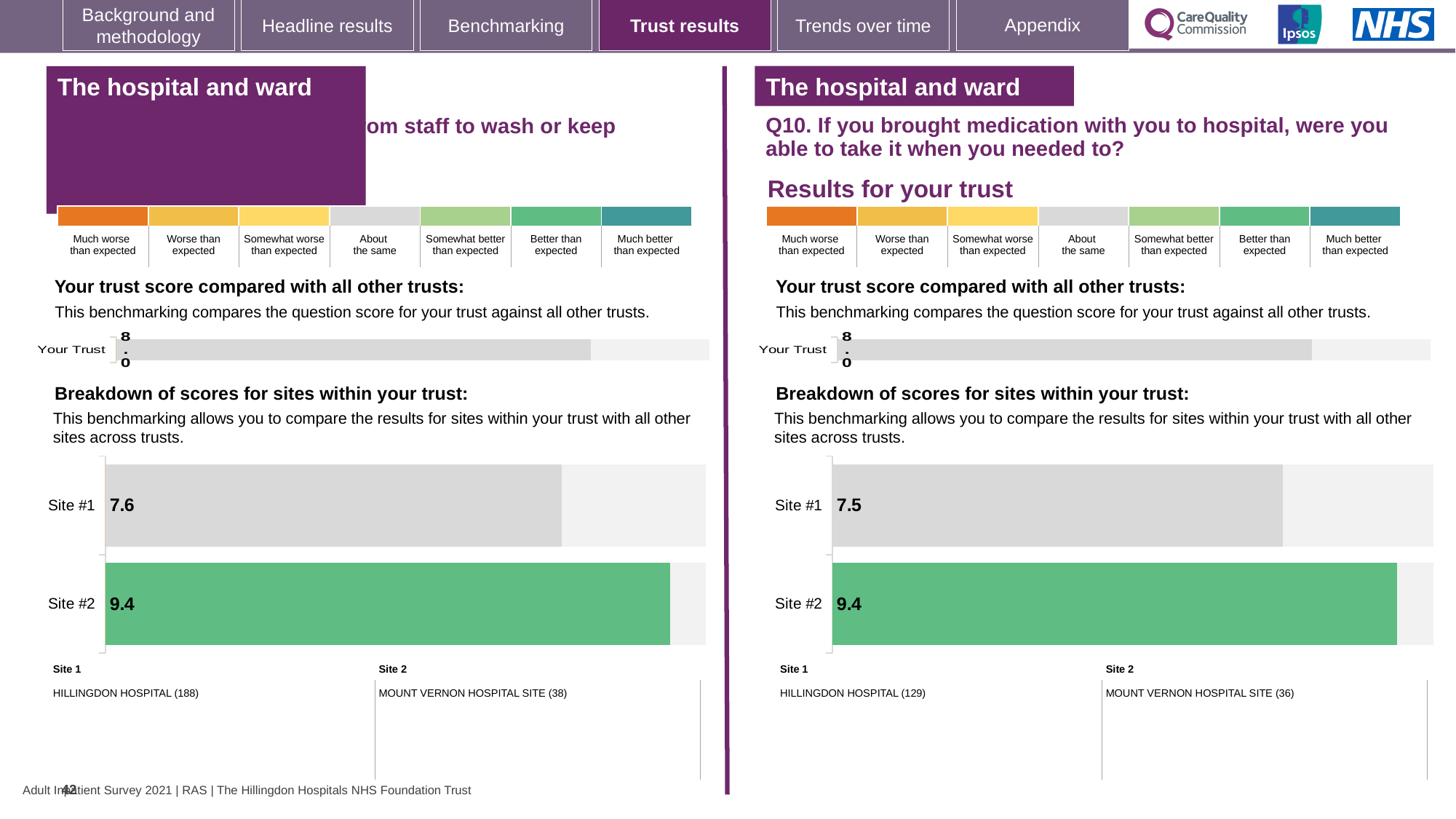
In the site breakdown chart on the right-hand side of the slide (Q10), which site has the higher score? Site #2 What type of chart is used for the site breakdown on the right-hand side of the slide (Q10)? Bar chart In the site breakdown chart on the right-hand side of the slide (Q10), what is the score for Site #1? 7.5 In the site breakdown chart on the left-hand side of the slide, what is the score for Site #1? 7.6 How many sites are shown in the site breakdown chart on the right-hand side of the slide (Q10)? 2 In the site breakdown chart on the left-hand side of the slide, what is the score for Site #2? 9.4 In the site breakdown chart on the left-hand side of the slide, what is the difference between the Site #2 and Site #1 scores? 1.8 In the site breakdown chart on the left-hand side of the slide, which site has the lower score? Site #1 In the site breakdown chart on the right-hand side of the slide (Q10), what is the score for Site #2? 9.4 In the site breakdown chart on the right-hand side of the slide (Q10), what colour is the bar for Site #2? Green In the site breakdown chart on the right-hand side of the slide (Q10), what is the difference between the Site #2 and Site #1 scores? 1.9 In the 'Your trust score compared with all other trusts' chart on the right-hand side of the slide (Q10), what is the score shown for Your Trust? 8.0